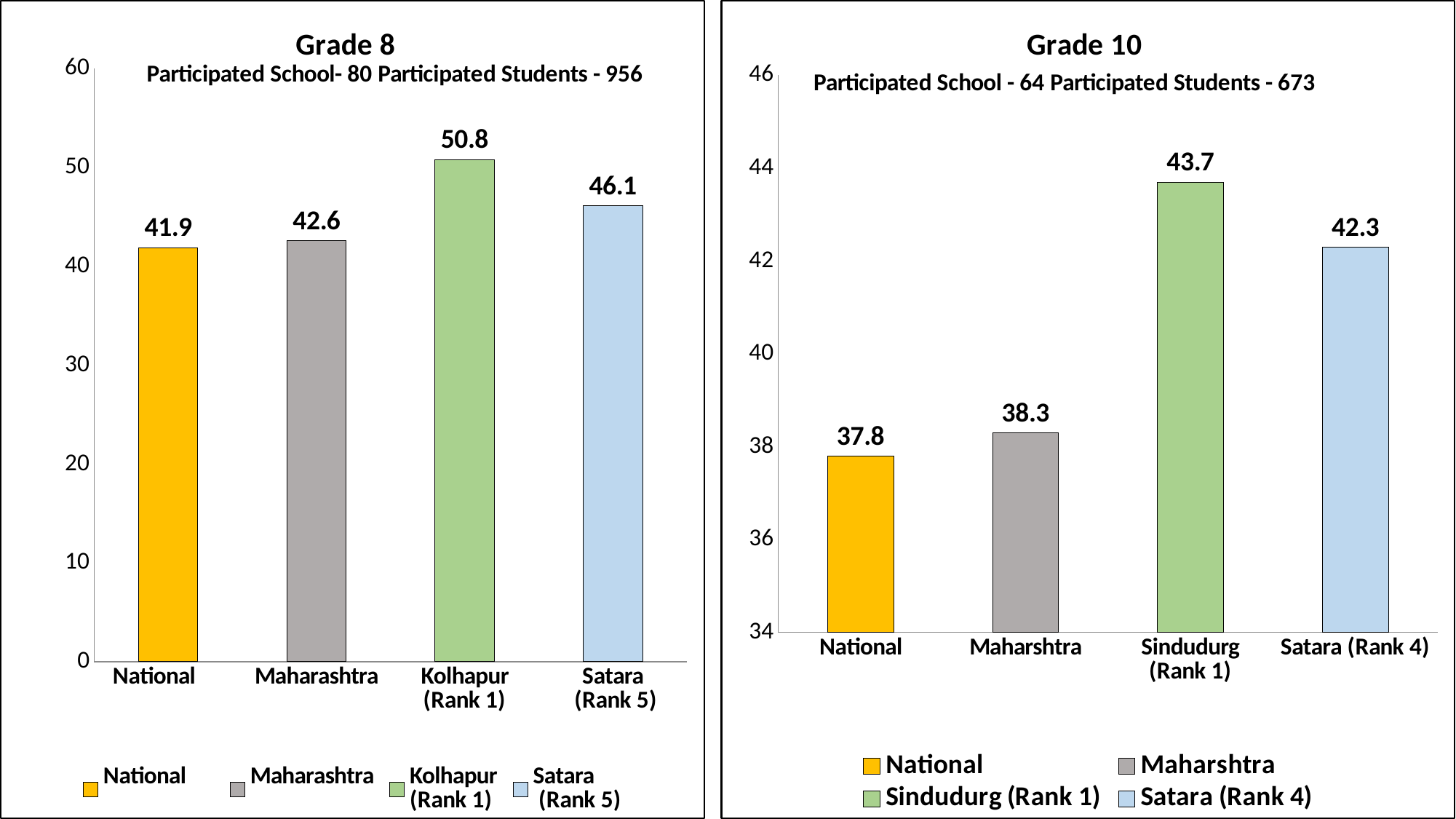
In the Grade 10 chart, what is the value for Sindudurg (Rank 1)? 43.7 In the Grade 8 chart, what is the value for Kolhapur (Rank 1)? 50.8 In the Grade 8 chart, what is the difference between the values for Kolhapur (Rank 1) and Satara (Rank 5)? 4.7 In the Grade 10 chart, what is the difference between the values for Sindudurg (Rank 1) and National? 5.9 How many categories are shown in the Grade 8 chart? 4 In the Grade 10 chart, which category has the lowest value? National In the Grade 10 chart, which is larger, the value for Satara (Rank 4) or the value for Maharshtra? Satara (Rank 4) In the Grade 8 chart, what is the value for National? 41.9 In the Grade 10 chart, what is the value for Maharshtra? 38.3 In the Grade 8 chart, which category has the highest value? Kolhapur (Rank 1) In the Grade 8 chart, how many participated students are stated in the subtitle? 956 What kind of chart is the Grade 10 chart? bar chart